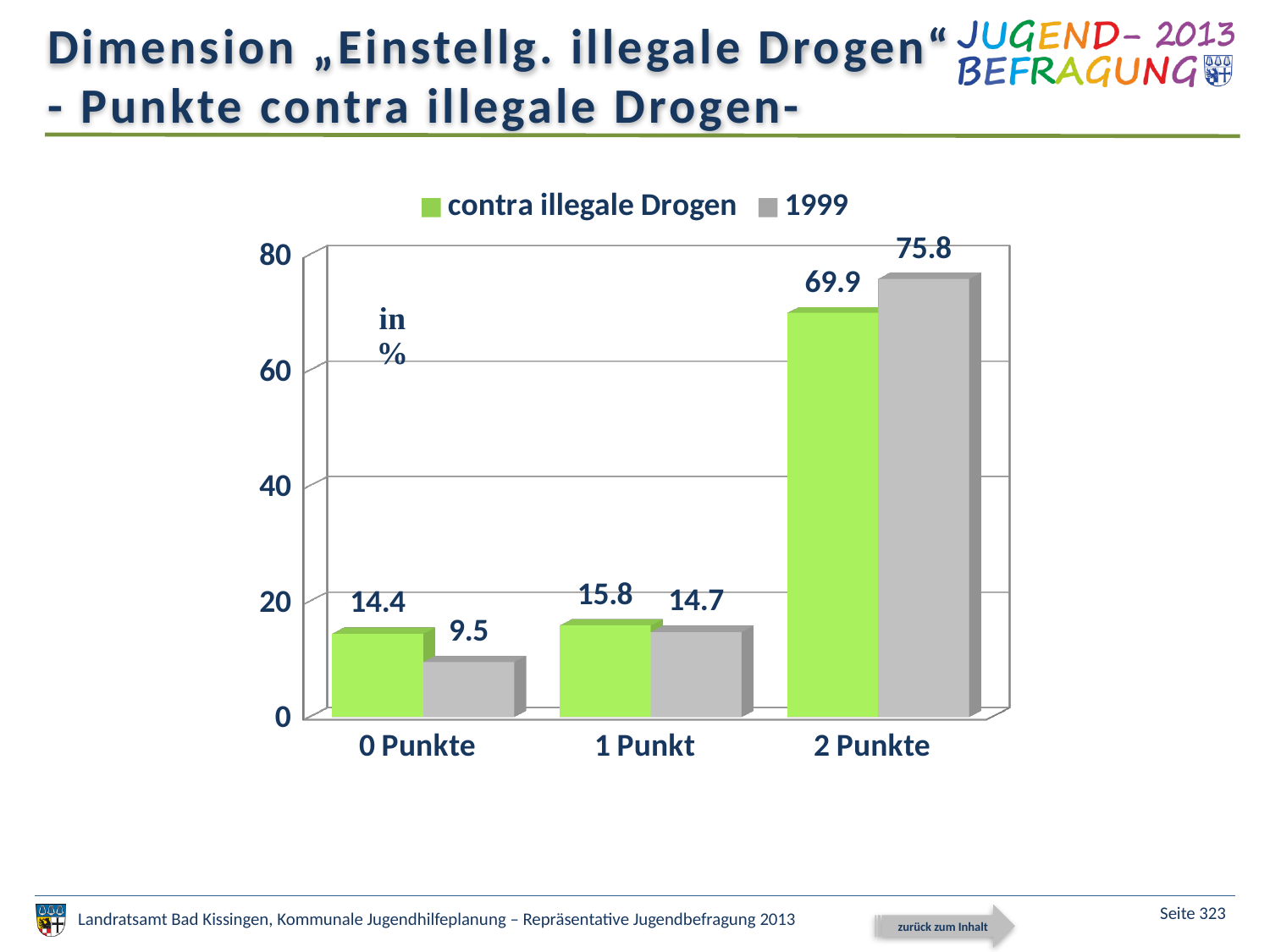
What is the value for 1999 at 0 Punkte? 9.5 Which colour represents the 1999 series? grey What kind of chart is shown on the slide? bar chart Which category has the highest value for "contra illegale Drogen"? 2 Punkte How many series does the legend list? 2 What is the value for "contra illegale Drogen" at 0 Punkte? 14.4 Which category has the lowest value for 1999? 0 Punkte Is the value for "contra illegale Drogen" at 2 Punkte greater or less than 60? greater What is the difference between the 1999 value and the "contra illegale Drogen" value at 2 Punkte? 5.9 What is the value for 1999 at 2 Punkte? 75.8 At 0 Punkte, which series has the larger value: "contra illegale Drogen" or 1999? contra illegale Drogen How many categories are shown on the x axis? 3